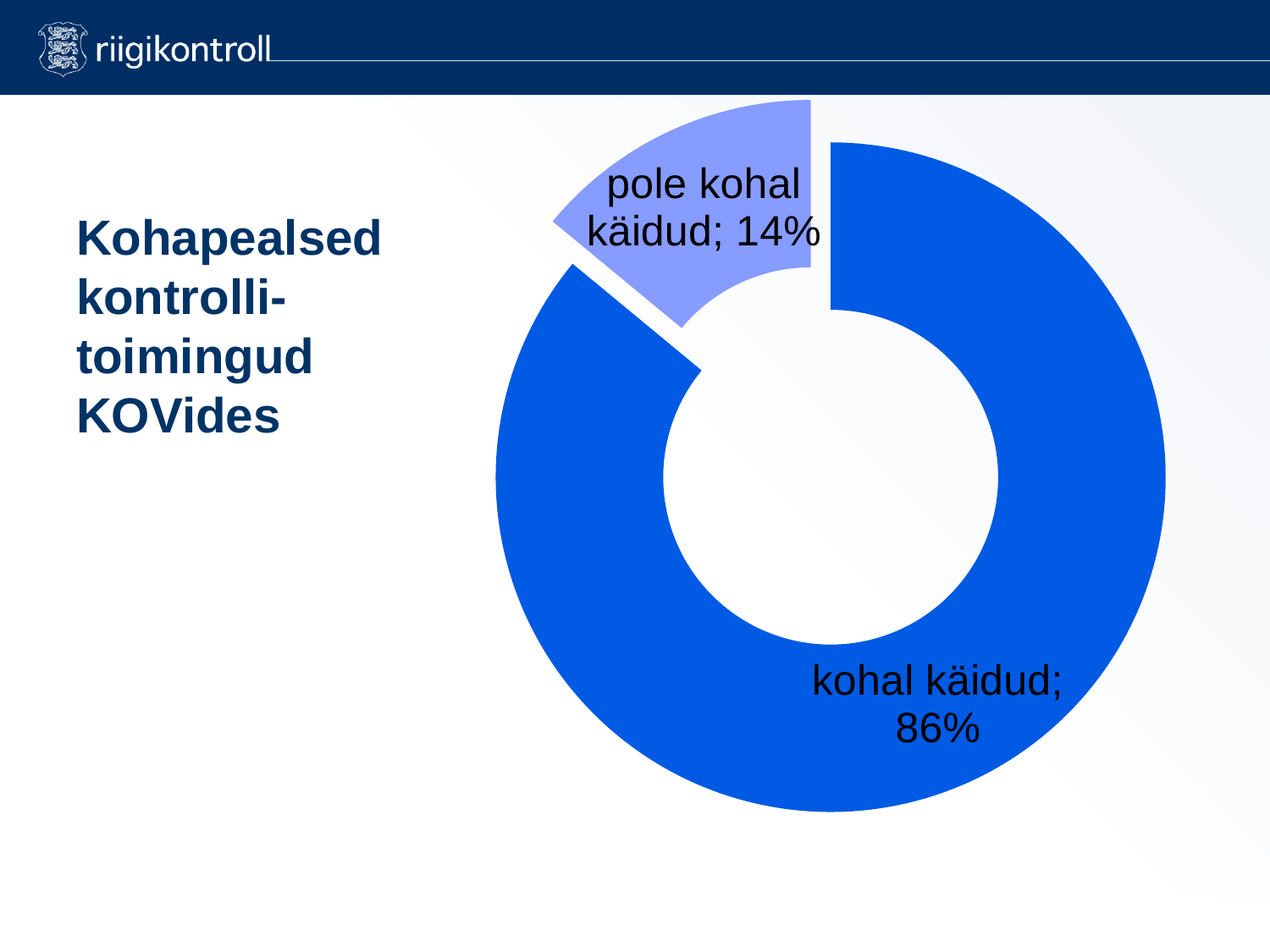
What share of the chart does the "pole kohal käidud" slice represent? 14% What is the title text shown to the left of the chart? Kohapealsed kontrolli-toimingud KOVides How many slices does the chart have? 2 What share of the chart does the "kohal käidud" slice represent? 86% What kind of chart is shown on the slide? Doughnut (pie) chart Which slice is the largest in the chart? kohal käidud Which slice is the smallest in the chart? pole kohal käidud Which slice is shown in the lighter blue colour? pole kohal käidud Which is larger: the "kohal käidud" slice or the "pole kohal käidud" slice? kohal käidud What is the difference in percentage points between the "kohal käidud" and "pole kohal käidud" slices? 72